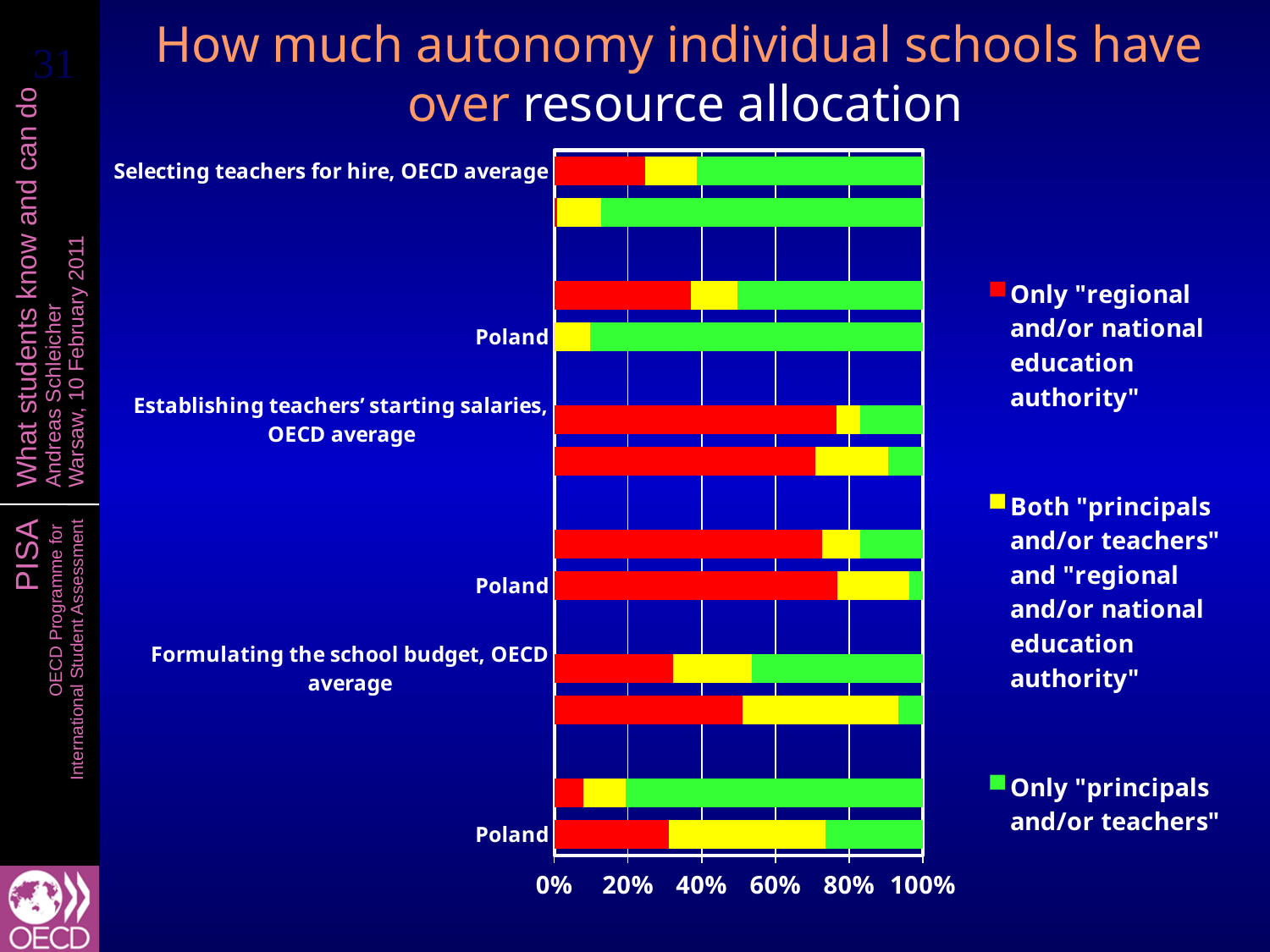
For "Selecting teachers for hire, OECD average", which is larger: the red segment or the green segment? Green (Only "principals and/or teachers") For "Establishing teachers' starting salaries, OECD average", which is larger: the red segment or the green segment? Red (Only "regional and/or national education authority") How many series does the legend list? 3 Which legend entry is shown in green? Only "principals and/or teachers" How many bars are plotted in the chart? 12 Which legend entry is shown in red? Only "regional and/or national education authority" Is the red segment (Only "regional and/or national education authority") for "Selecting teachers for hire, OECD average" greater or less than 40%? less What kind of chart is shown on the slide? Stacked bar chart Is the red segment (Only "regional and/or national education authority") for "Establishing teachers' starting salaries, OECD average" greater or less than 60%? greater What is the highest value shown on the x axis? 100% Is the green segment for the Poland bar under "Selecting teachers for hire" greater or less than 80%? greater